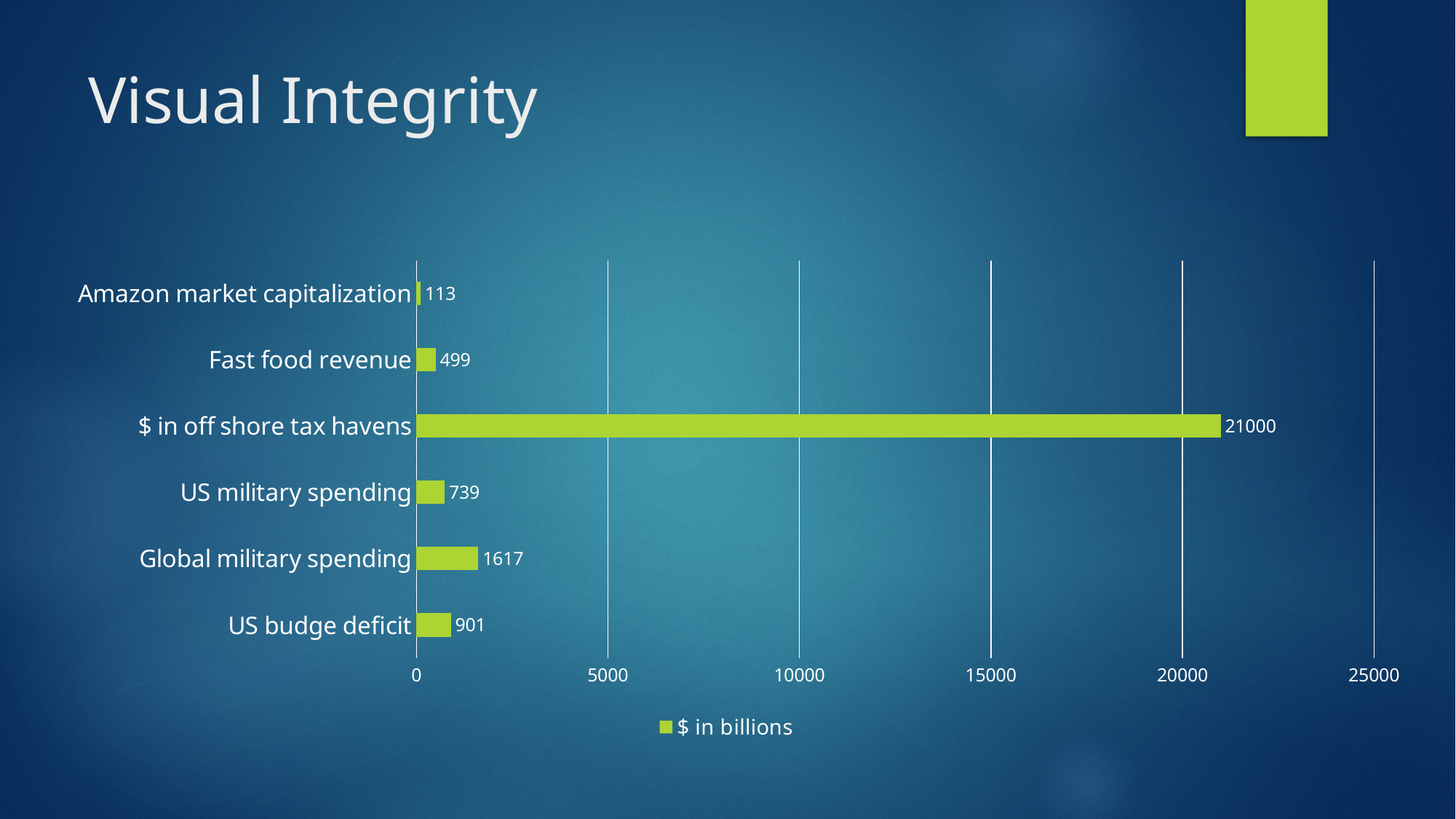
What kind of chart is shown on the slide? bar chart What is the difference between Global military spending and US military spending? 878 What is the value for $ in off shore tax havens? 21000 Which category has the lowest value? Amazon market capitalization Which is larger, US budge deficit or Fast food revenue? US budge deficit What series does the legend list? $ in billions What is the value for US budge deficit? 901 What is the value for Amazon market capitalization? 113 How many categories are shown in the chart? 6 Which category has the highest value? $ in off shore tax havens What is the value for Global military spending? 1617 Is the value for $ in off shore tax havens greater or less than 20000? greater